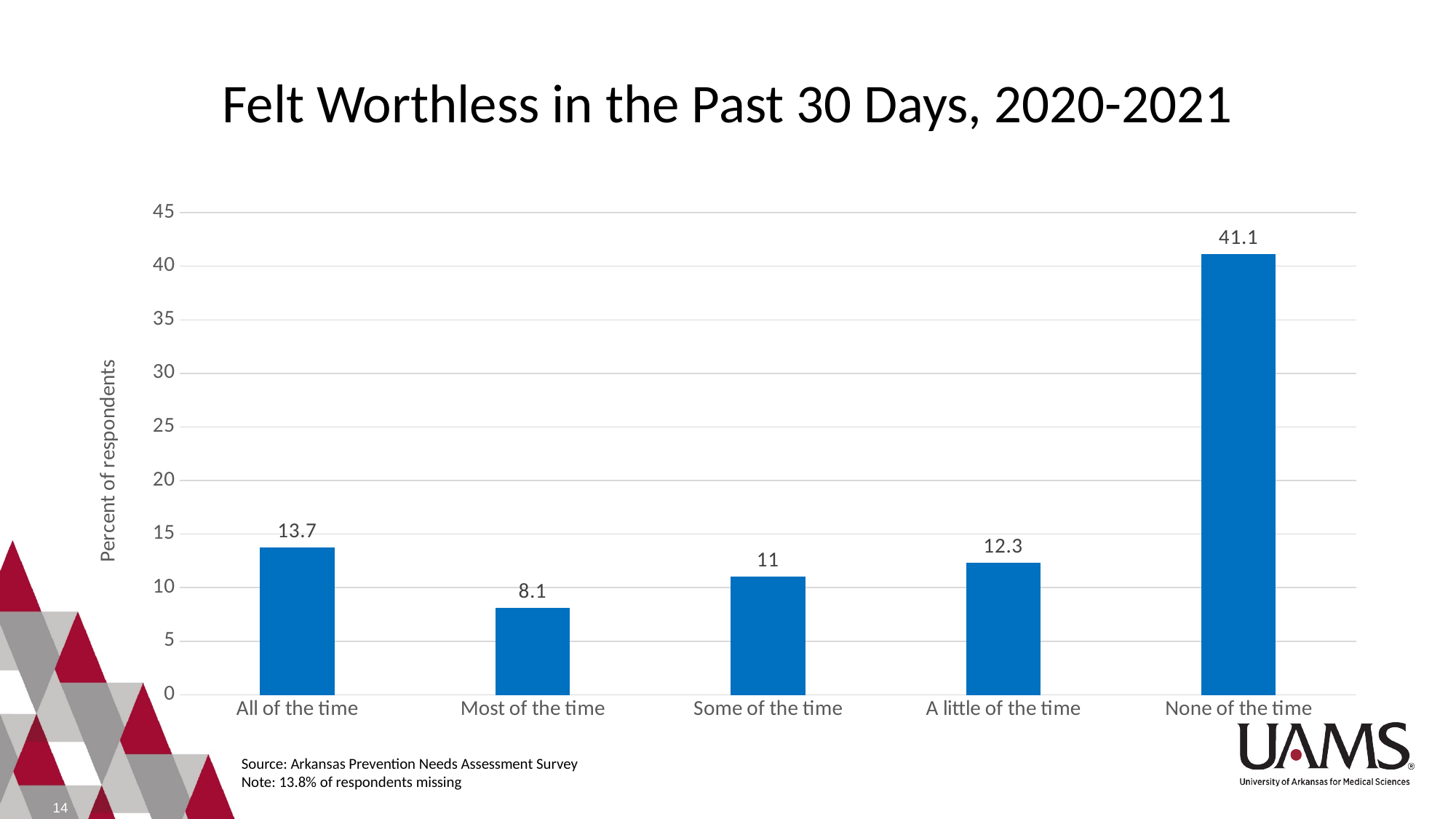
How many categories are shown on the x axis? 5 Is the value for "None of the time" greater or less than 40? greater What is the value for "All of the time"? 13.7 What kind of chart is shown on the slide? Bar chart Which is larger, the value for "All of the time" or the value for "A little of the time"? All of the time What is the value for "None of the time"? 41.1 What is the difference between the values for "None of the time" and "All of the time"? 27.4 What is the value for "Most of the time"? 8.1 What is the value for "Some of the time"? 11 What is the label of the vertical axis? Percent of respondents Which category has the highest value? None of the time Which category has the lowest value? Most of the time